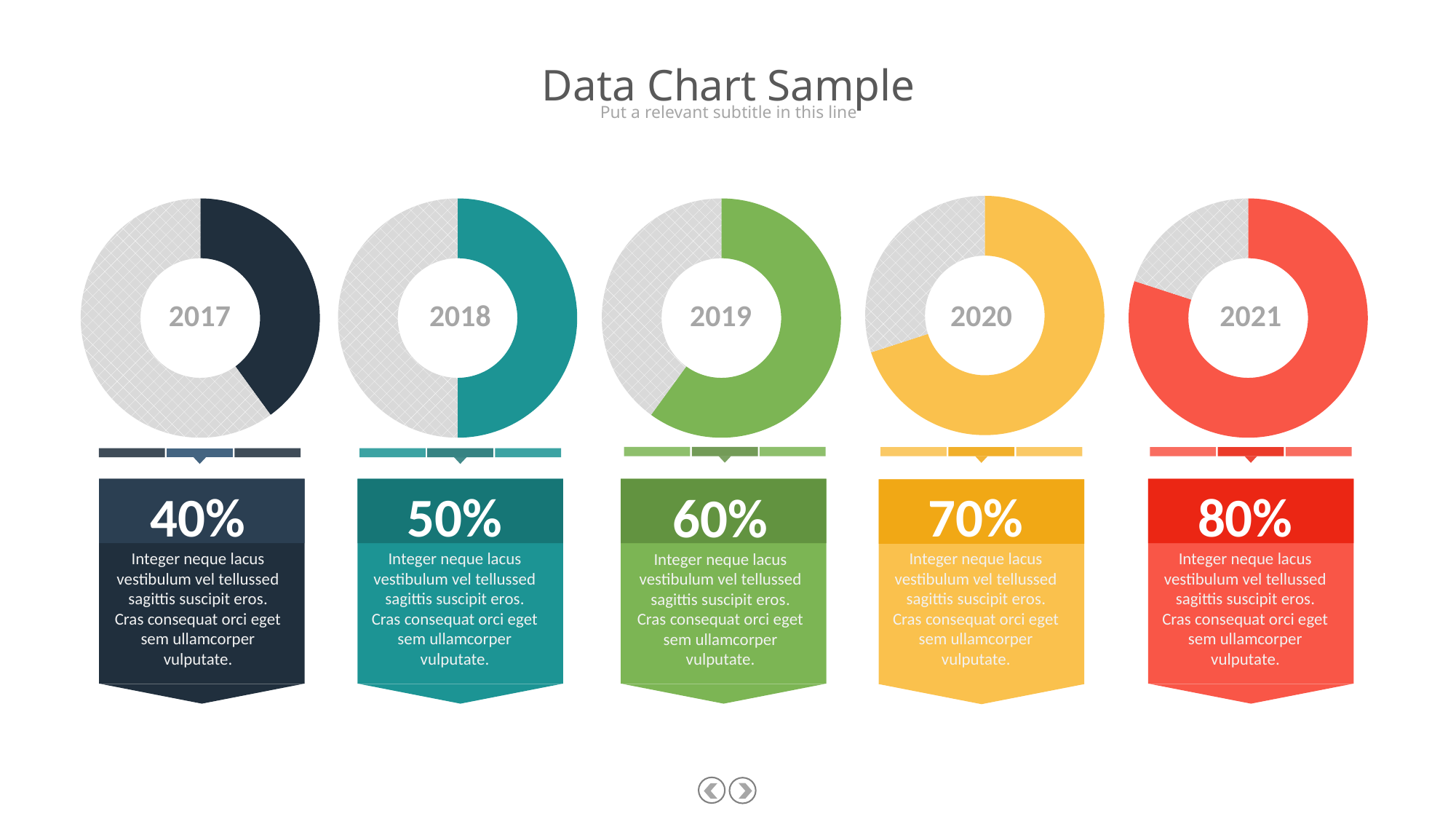
What percentage is shown for the 2021 donut chart? 80% What percentage is shown for the 2019 donut chart? 60% What is the difference between the percentage for 2020 and the percentage for 2018? 20% What is the title of the slide? Data Chart Sample How many donut charts are on the slide? 5 Which year's donut chart shows the highest percentage? 2021 Do the percentages rise or fall from 2017 to 2021? Rise Which year's donut chart shows the lowest percentage? 2017 Which is larger, the percentage for 2019 or the percentage for 2018? 2019 What colour is the filled portion of the 2020 donut chart? Yellow What kind of chart is used for each year on the slide? Donut chart What percentage is shown for the 2017 donut chart? 40%